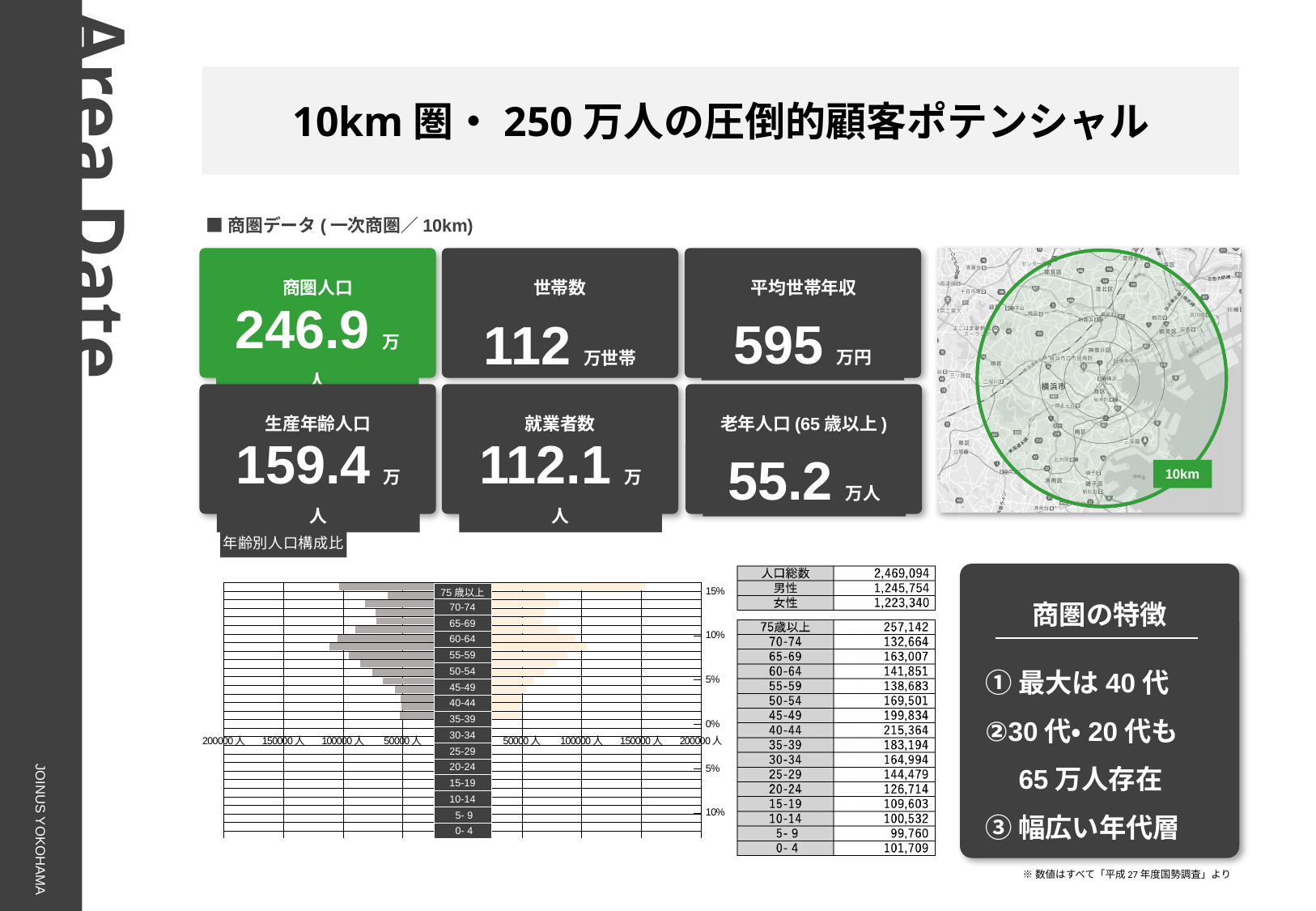
In the table next to the 年齢別人口構成比 chart, what is the 人口総数 value? 2,469,094 According to the table next to the 年齢別人口構成比 chart, which age group has the larger population, 45-49 or 50-54? 45-49 In the table next to the 年齢別人口構成比 chart, what is the population for the 75歳以上 age group? 257,142 In the table next to the 年齢別人口構成比 chart, what is the 男性 value? 1,245,754 What kind of chart is the 年齢別人口構成比 chart? bar chart How many age-group categories are listed on the 年齢別人口構成比 chart? 16 According to the table next to the 年齢別人口構成比 chart, which age group has the largest population? 75歳以上 According to the table next to the 年齢別人口構成比 chart, which age group has the smallest population? 5-9 What is the title of the population pyramid chart on the slide? 年齢別人口構成比 According to the table next to the 年齢別人口構成比 chart, what is the difference in population between the 40-44 and 35-39 age groups? 32,170 In the table next to the 年齢別人口構成比 chart, what is the population for the 40-44 age group? 215,364 Which age group is at the top of the 年齢別人口構成比 chart? 75歳以上